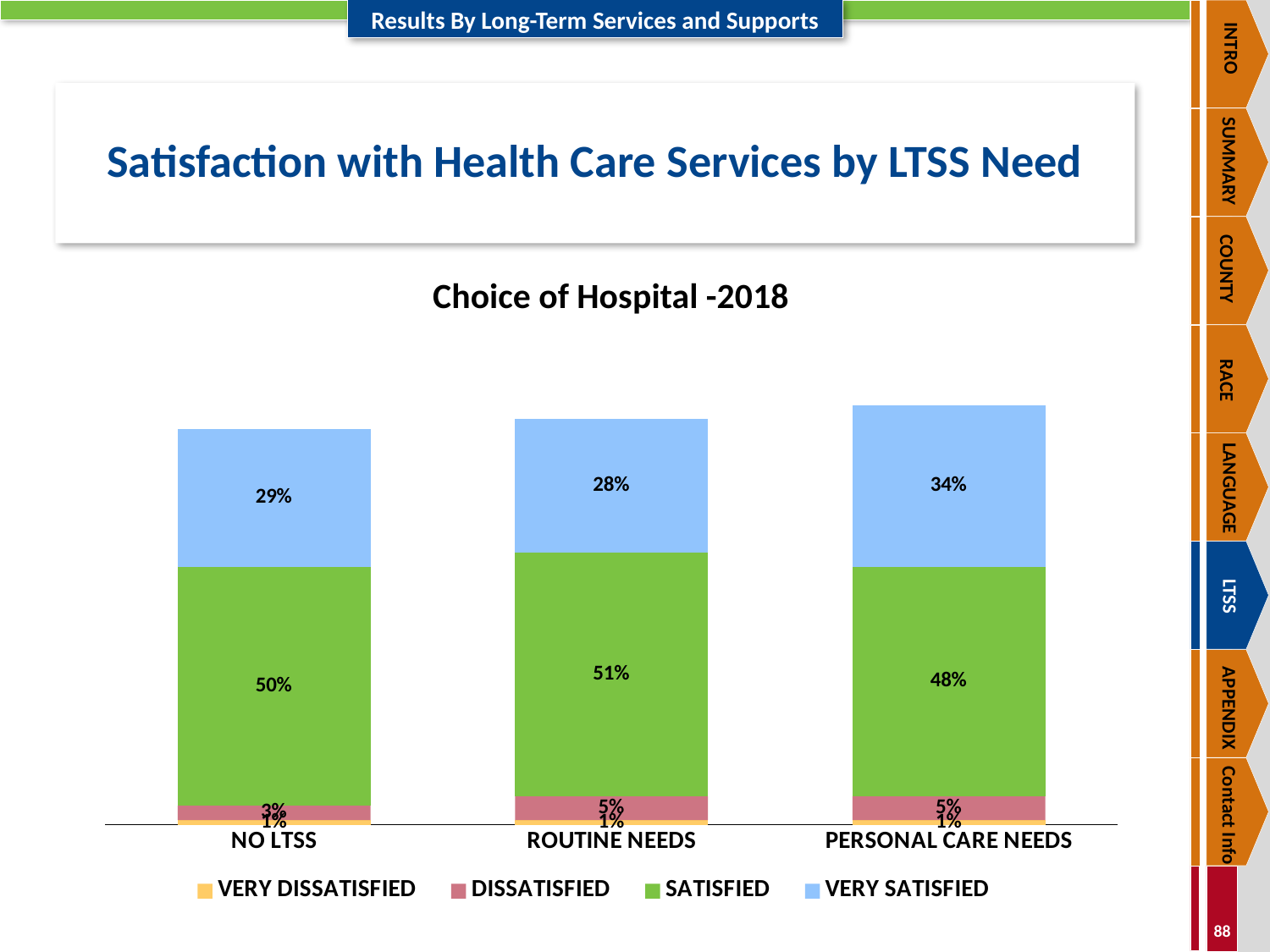
What kind of chart is shown? Stacked bar chart Which category has the highest VERY SATISFIED percentage? PERSONAL CARE NEEDS What is the title of the chart? Choice of Hospital -2018 Which category has the lowest SATISFIED percentage? PERSONAL CARE NEEDS What is the VERY SATISFIED value for PERSONAL CARE NEEDS? 34% What is the SATISFIED value for ROUTINE NEEDS? 51% What is the DISSATISFIED value for NO LTSS? 3% What is the difference between the VERY SATISFIED values for PERSONAL CARE NEEDS and ROUTINE NEEDS? 6% Which is larger, the DISSATISFIED value for ROUTINE NEEDS or for NO LTSS? ROUTINE NEEDS How many series does the legend list? 4 How many categories are shown on the x axis? 3 What percentage of respondents with no LTSS were very satisfied with their choice of hospital? 29%